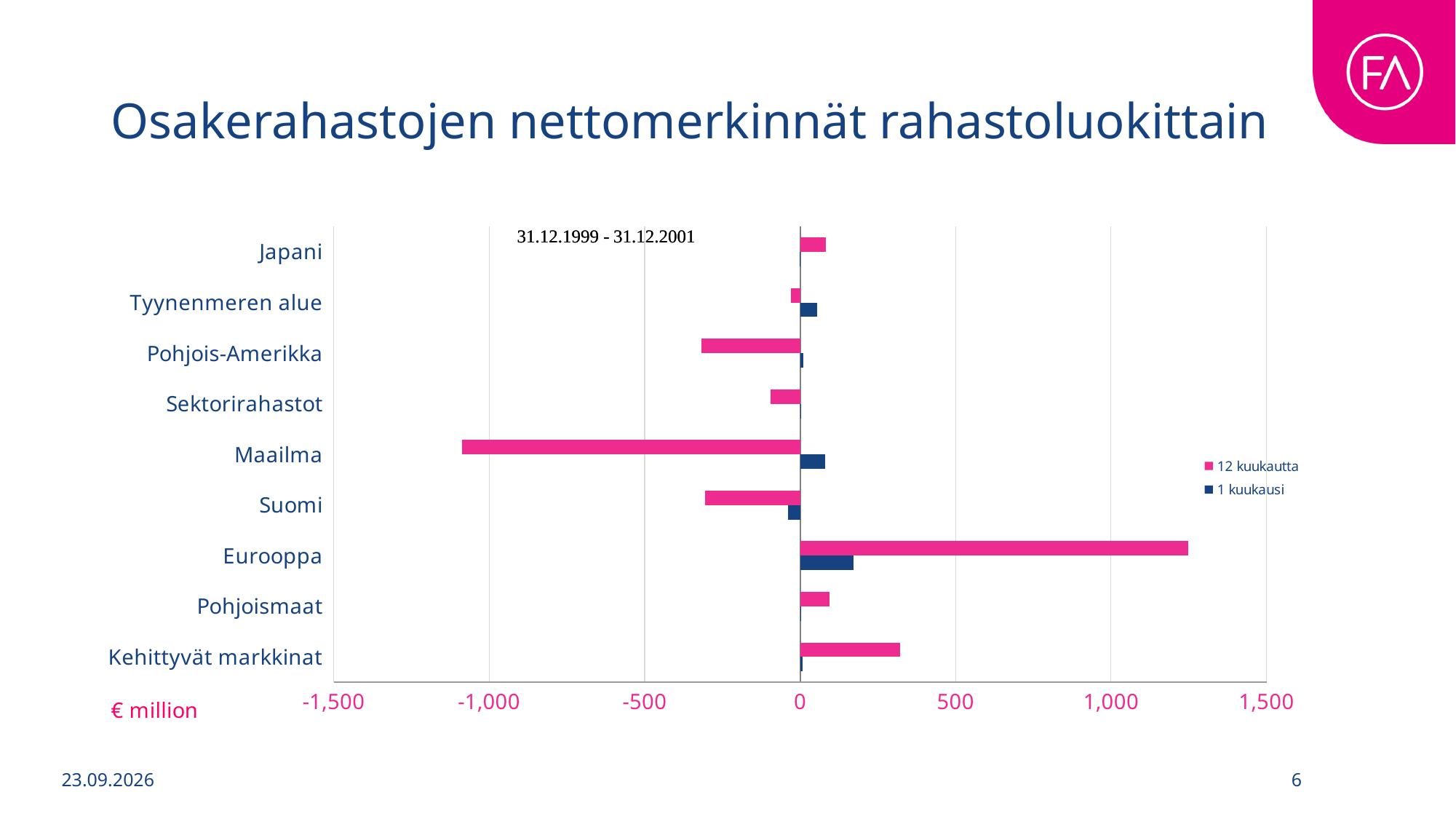
Is the 12 kuukautta value for Kehittyvät markkinat greater or less than 500? less Which category has the lowest 12 kuukautta value? Maailma Which category has the highest 12 kuukautta value? Eurooppa Which has the larger 1 kuukausi value, Eurooppa or Maailma? Eurooppa What period is stated in the text inside the chart area? 31.12.1999 - 31.12.2001 How many series does the legend list? 2 Is the 12 kuukautta value for Maailma greater or less than -1,000? less Is the 12 kuukautta value for Pohjois-Amerikka greater or less than 0? less What kind of chart is shown on the slide? bar chart What unit is shown for the x axis of the chart? € million How many fund categories are shown on the chart? 9